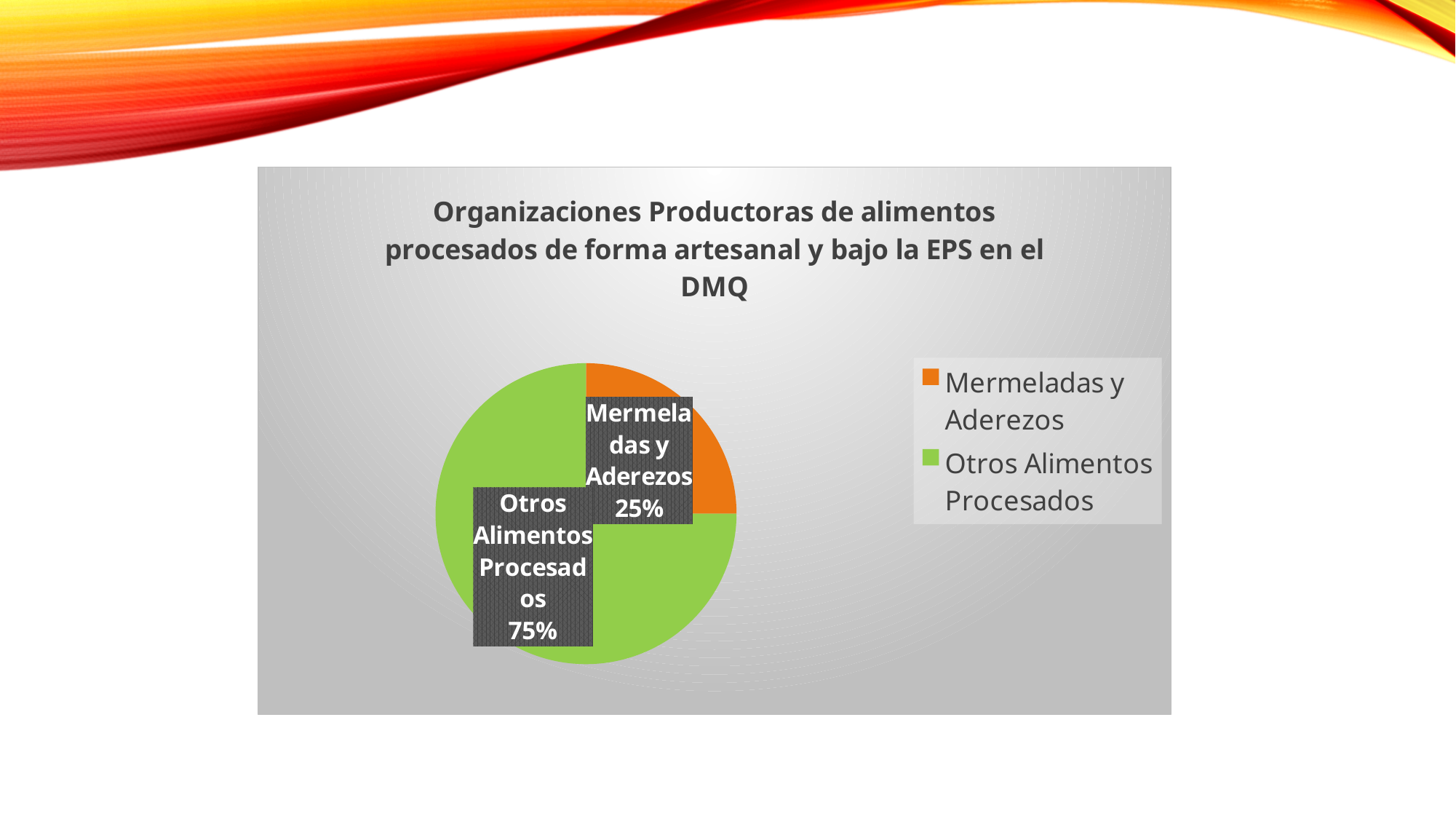
What colour is the slice for Mermeladas y Aderezos? Orange How many entries does the legend list? 2 Which is larger, the slice for Mermeladas y Aderezos or the slice for Otros Alimentos Procesados? Otros Alimentos Procesados What share of the pie does Otros Alimentos Procesados represent? 75% What is the title of the chart? Organizaciones Productoras de alimentos procesados de forma artesanal y bajo la EPS en el DMQ Which category has the smallest slice of the pie? Mermeladas y Aderezos How many categories are shown in the pie chart? 2 What share of the pie does Mermeladas y Aderezos represent? 25% What kind of chart is shown on the slide? Pie chart Which category has the largest slice of the pie? Otros Alimentos Procesados What is the difference in percentage points between Otros Alimentos Procesados and Mermeladas y Aderezos? 50